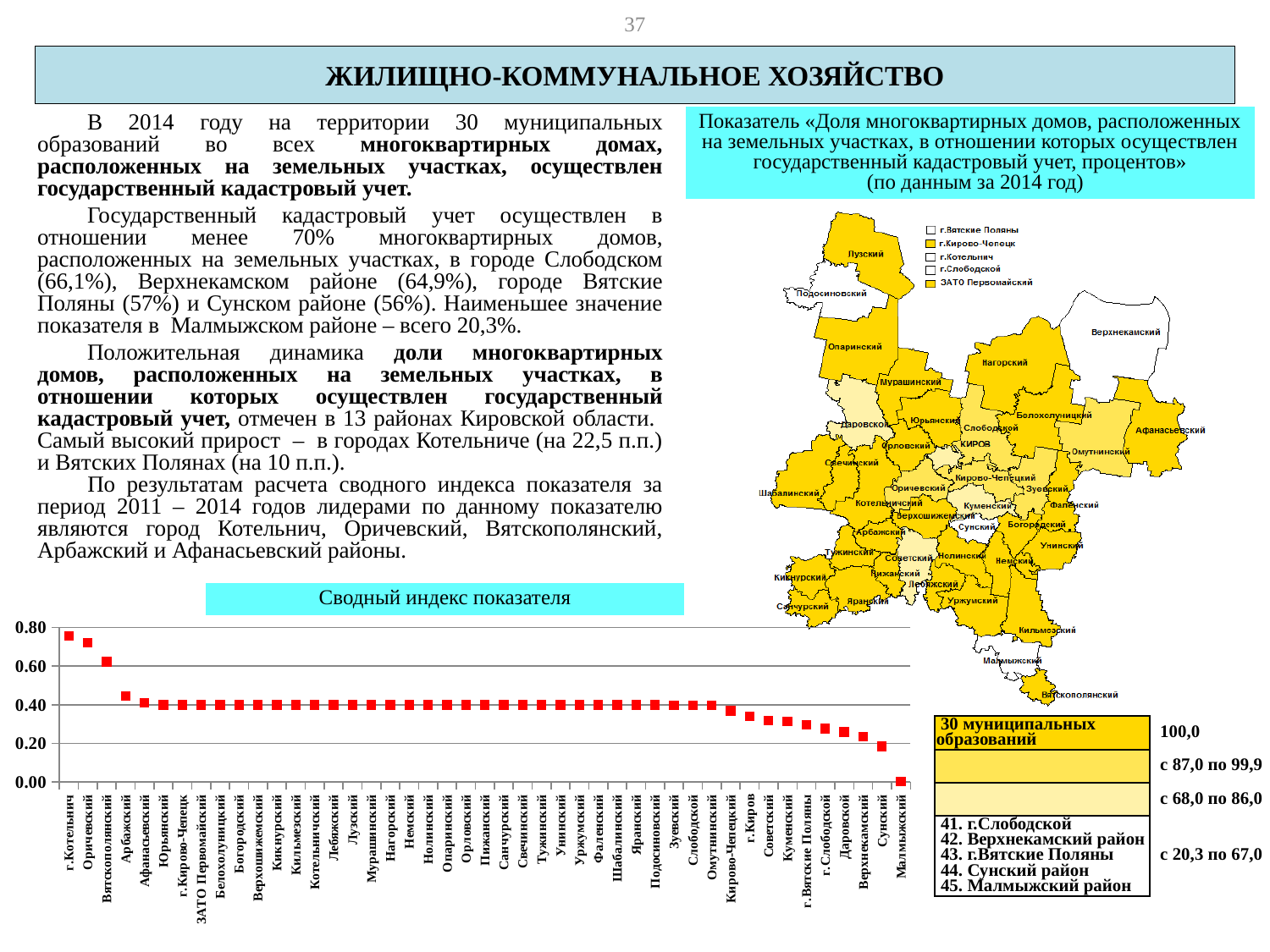
What is the highest value shown on the y axis of the chart 'Сводный индекс показателя'? 0.80 In the chart 'Сводный индекс показателя', is the value for Оричевский greater or less than 0.60? greater In the chart 'Сводный индекс показателя', is the value for г.Котельнич greater or less than 0.60? greater In the chart 'Сводный индекс показателя', which has the larger value, Малмыжский or Оричевский? Оричевский In the chart 'Сводный индекс показателя', is the value for Даровский greater or less than 0.40? less In the chart 'Сводный индекс показателя', which category has the highest value? г.Котельнич In the chart 'Сводный индекс показателя', which category has the lowest value? Малмыжский What is the title of the chart at the bottom of the slide? Сводный индекс показателя In the chart 'Сводный индекс показателя', which has the larger value, г.Котельнич or Сунский? г.Котельнич How many categories are plotted along the x axis of the chart 'Сводный индекс показателя'? 45 In the chart 'Сводный индекс показателя', do the values rise or fall from left to right along the x axis? fall